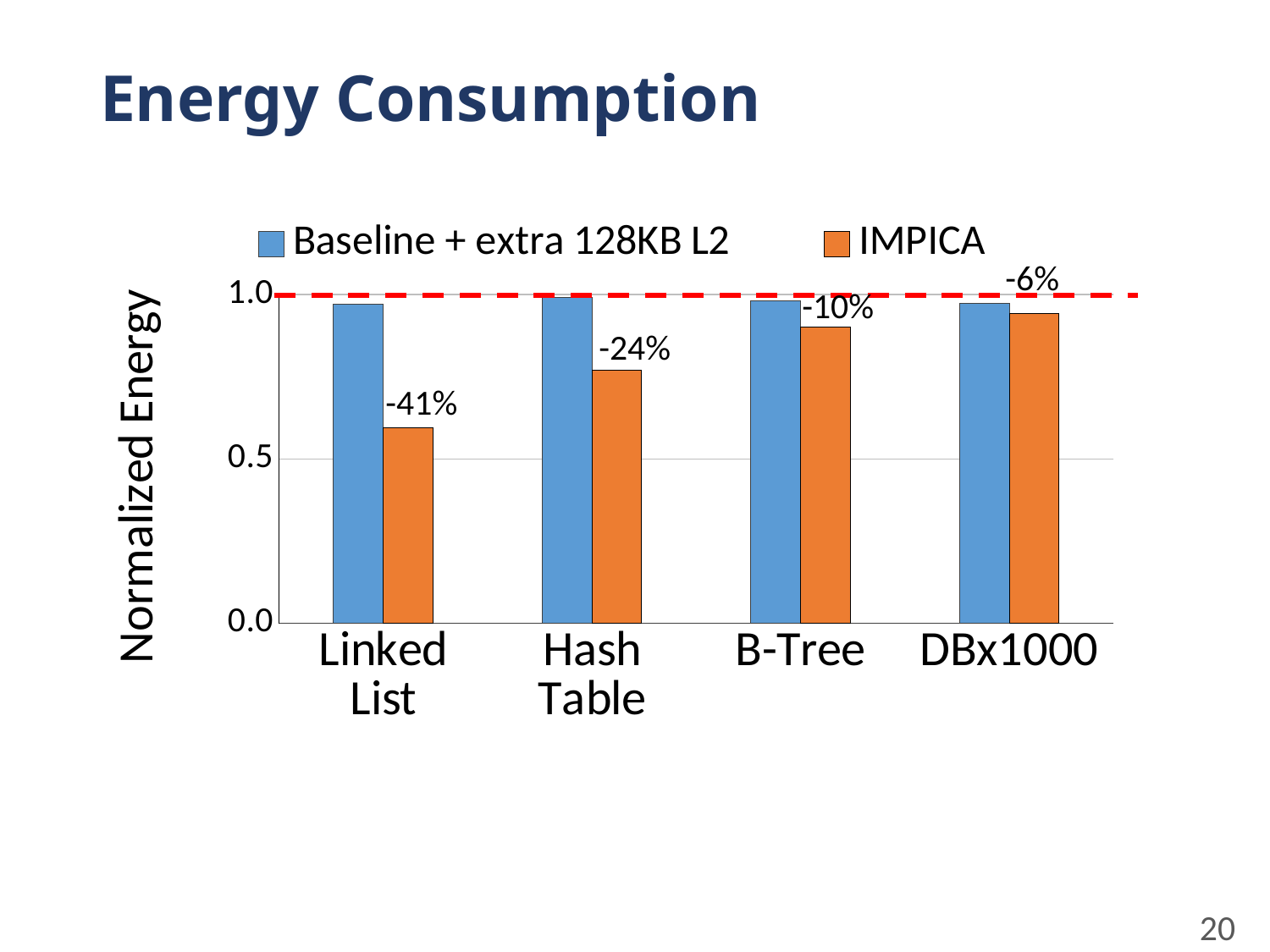
Which category has the highest IMPICA normalized energy? DBx1000 Which category has the lowest IMPICA normalized energy? Linked List What is the y-axis label of the chart? Normalized Energy How many categories are shown on the x axis? 4 What percentage label is printed above the IMPICA bar for Hash Table? -24% What percentage label is printed above the IMPICA bar for B-Tree? -10% Is the IMPICA normalized energy for Linked List greater or less than 0.5? greater What is the title of the slide containing the chart? Energy Consumption What kind of chart is shown on the slide? bar chart What percentage label is printed above the IMPICA bar for Linked List? -41% How many series does the legend list? 2 What percentage label is printed above the IMPICA bar for DBx1000? -6%